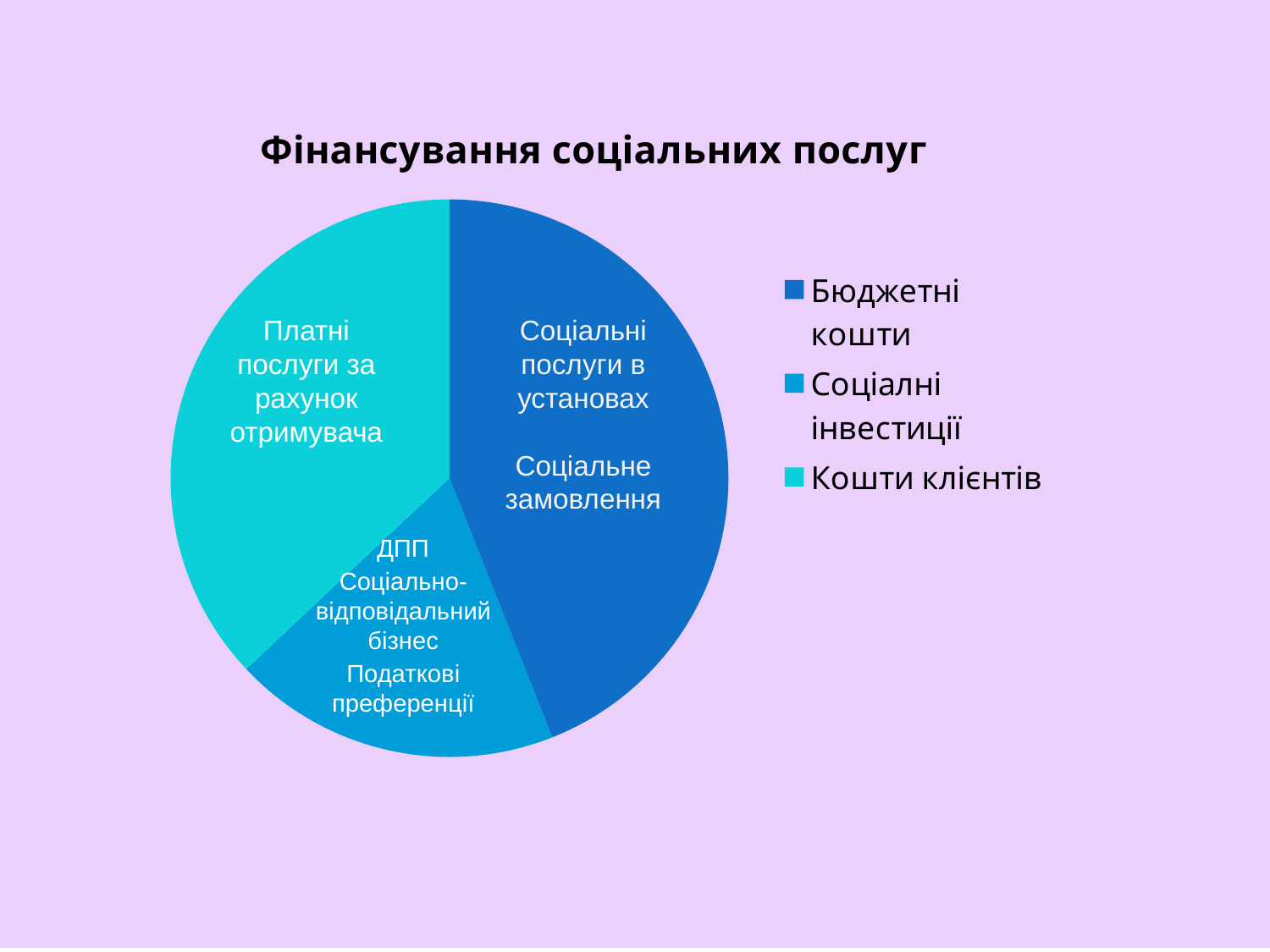
How many entries does the legend list? 3 Which legend entry is shown in the lightest (cyan) colour? Кошти клієнтів Which category has the smallest slice of the pie? Соціалні інвестиції What kind of chart is shown on the slide? Pie chart How many slices does the pie chart have? 3 What is the title of the chart? Фінансування соціальних послуг Which category has the largest slice of the pie? Бюджетні кошти Which slice is larger: Кошти клієнтів or Соціалні інвестиції? Кошти клієнтів Which slice is larger: Бюджетні кошти or Кошти клієнтів? Бюджетні кошти